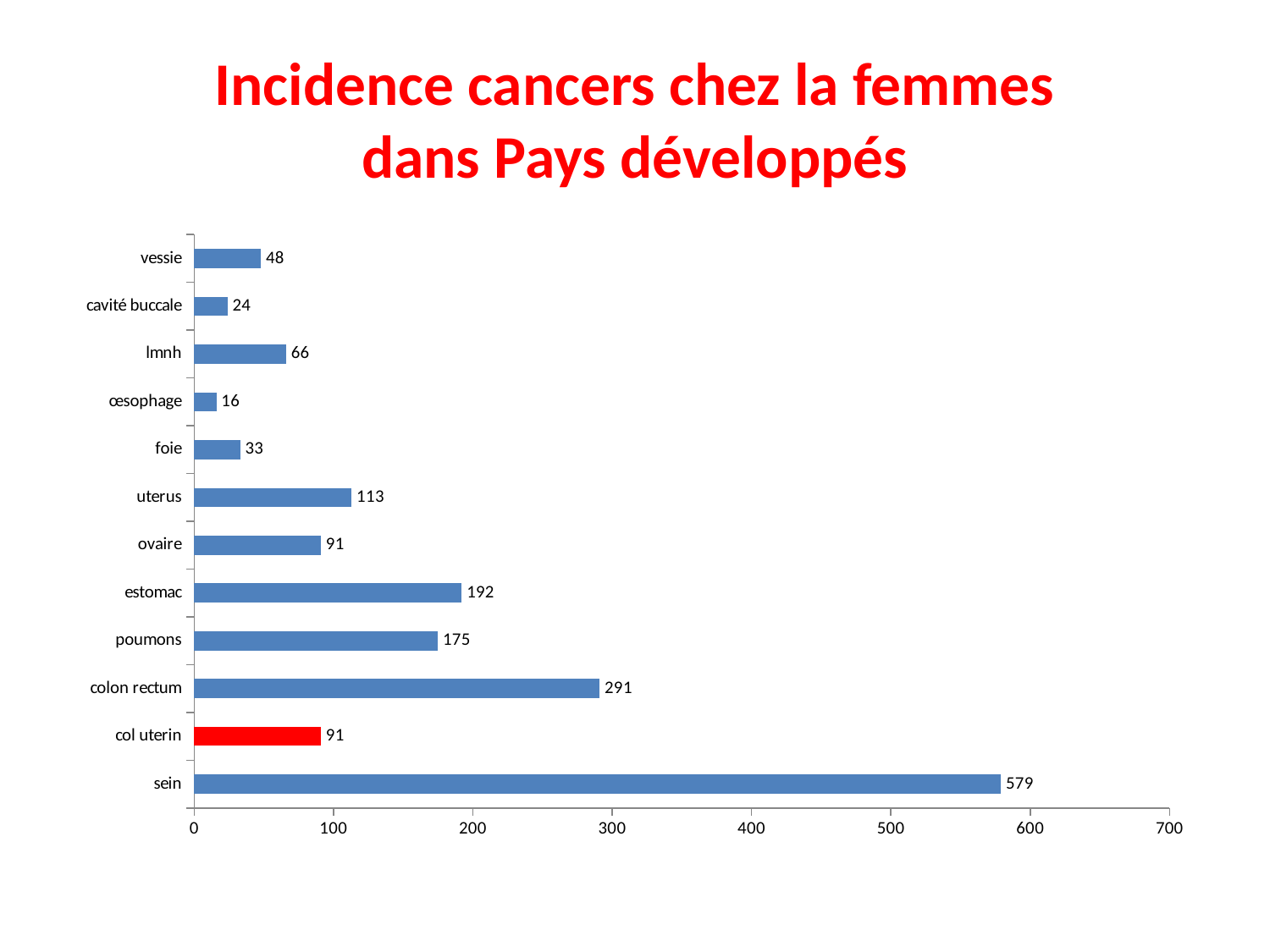
Which category has the highest value? sein What is the value for œsophage? 16 What kind of chart is shown on the slide? bar chart Which is larger, the value for uterus or the value for ovaire? uterus Which category's bar is coloured red? col uterin Which category has the lowest value? œsophage What is the value for sein? 579 What is the value for colon rectum? 291 What is the difference between the values for estomac and poumons? 17 What is the difference between the values for sein and colon rectum? 288 How many categories are shown in the chart? 12 Is the value for colon rectum greater or less than 300? less